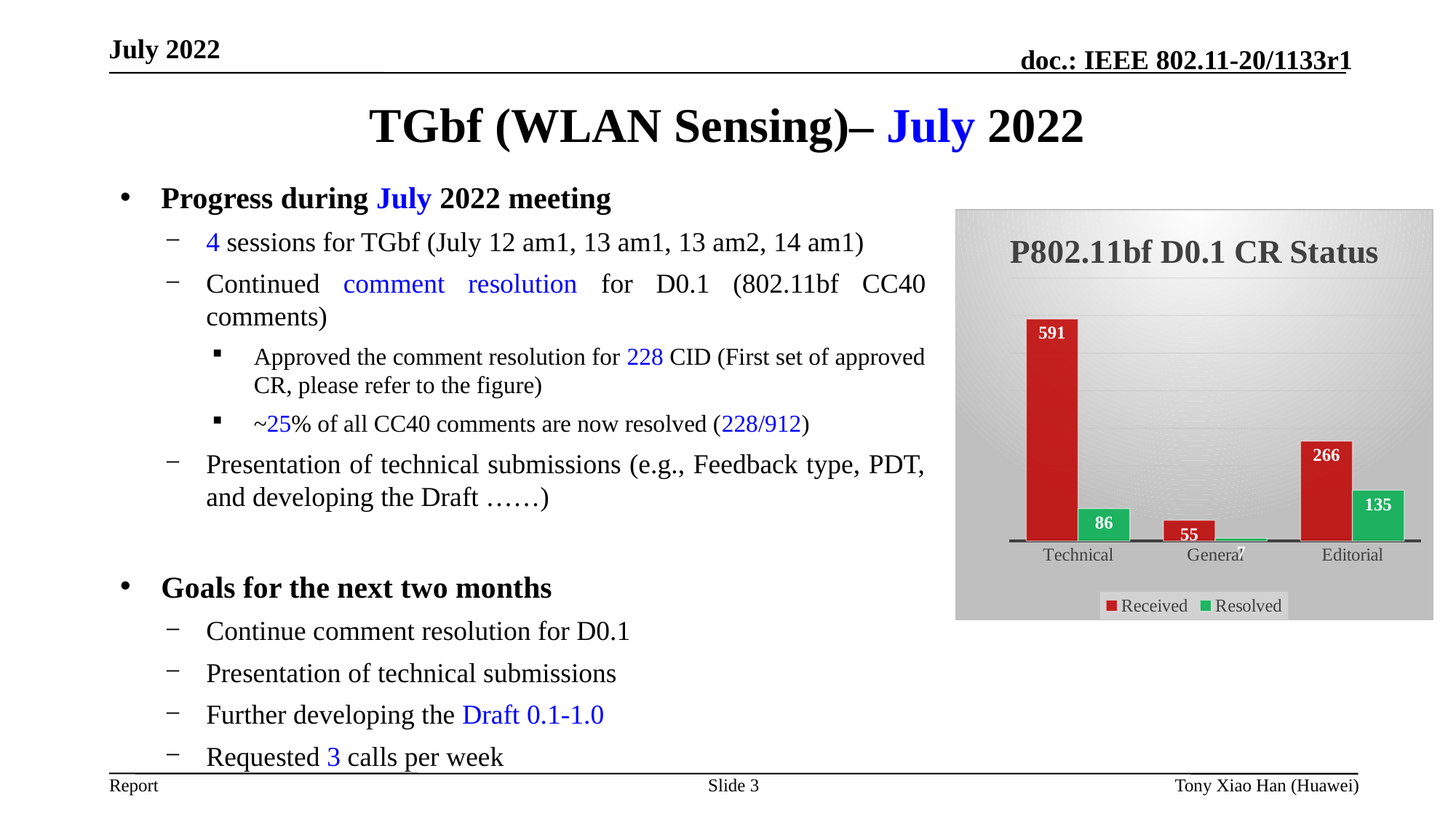
Which is larger, the Resolved value for Editorial or the Resolved value for Technical? Editorial What is the Received value for General? 55 What is the Resolved value for Editorial? 135 What is the Resolved value for Technical? 86 What is the Received value for Editorial? 266 What is the title of the chart? P802.11bf D0.1 CR Status What is the Received value for Technical? 591 How many series does the legend list? 2 How many categories are shown on the x axis? 3 Which category has the highest Received value? Technical What is the difference between the Received and Resolved values for Technical? 505 Which category has the lowest Received value? General